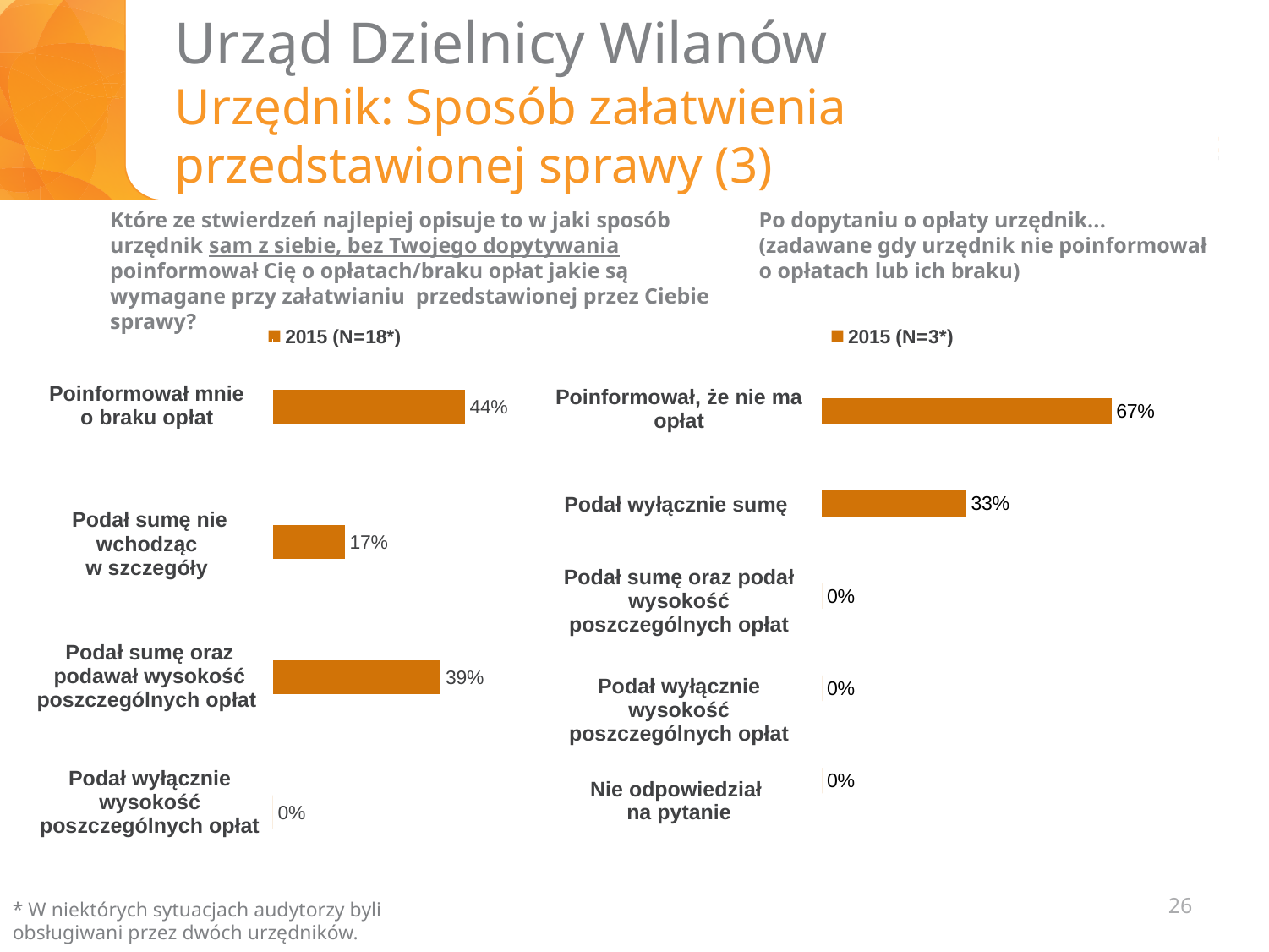
What type of chart is the left chart? Bar chart In the left chart, what is the difference between "Poinformował mnie o braku opłat" and "Podał sumę oraz podawał wysokość poszczególnych opłat"? 5 percentage points In the left chart, what is the value for "Podał sumę nie wchodząc w szczegóły"? 17% In the right chart, how many categories have a value of 0%? 3 What legend entry is shown for the right chart? 2015 (N=3*) In the right chart, which category has the highest value? Poinformował, że nie ma opłat In the right chart, what is the value for "Poinformował, że nie ma opłat"? 67% In the right chart, what is the value for "Podał wyłącznie sumę"? 33% In the right chart, what is the difference between "Poinformował, że nie ma opłat" and "Podał wyłącznie sumę"? 34 percentage points In the left chart, which category has the highest value? Poinformował mnie o braku opłat In the left chart, what is the value for "Poinformował mnie o braku opłat"? 44% In the left chart, how many categories are shown? 4